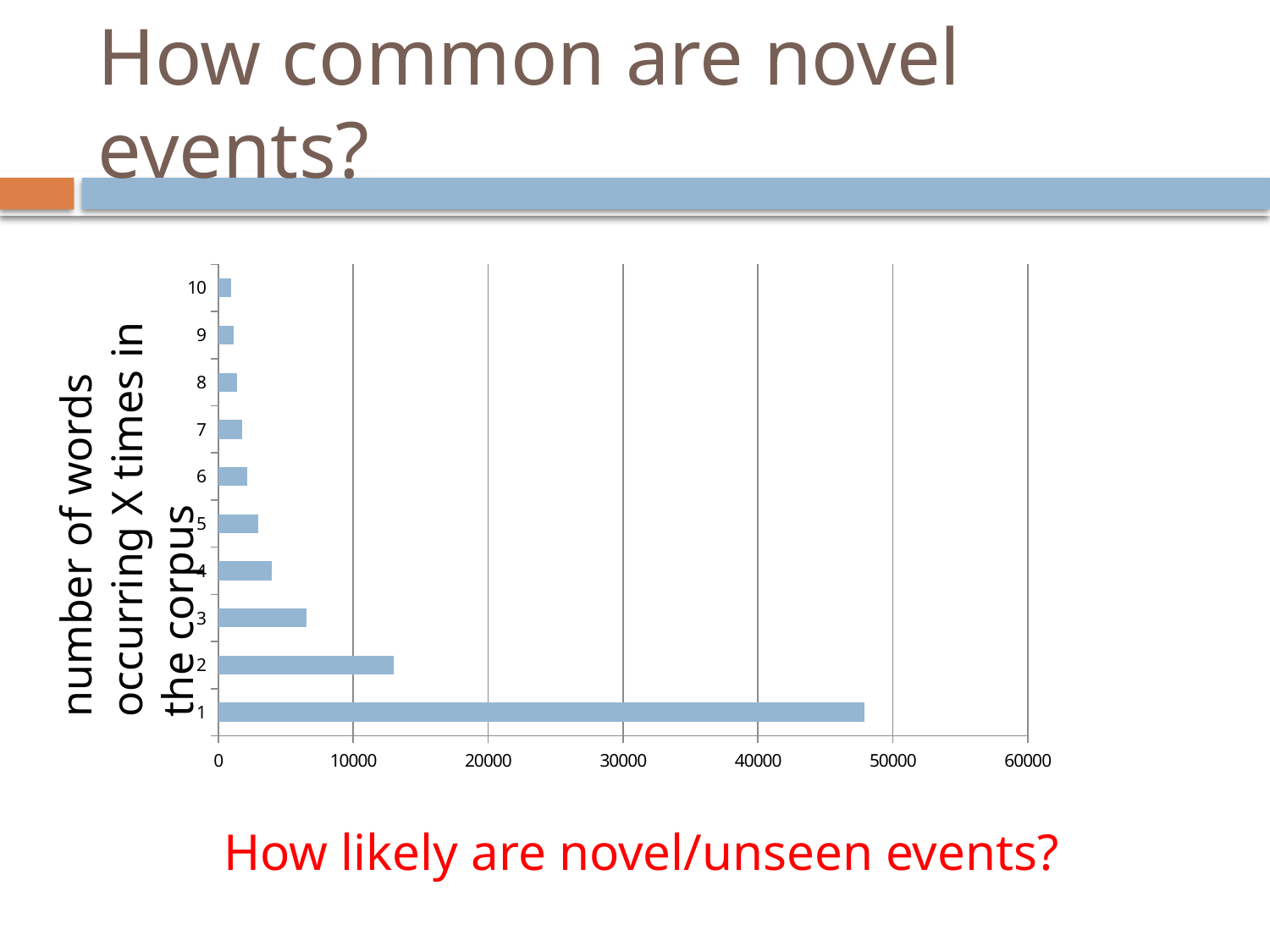
Do the bar values rise or fall as the category number increases from 1 to 10? fall What kind of chart is shown on the slide? bar chart Which is larger, the value for category 2 or the value for category 3? 2 Which category has the shortest bar in the chart? 10 Is the value for category 2 greater or less than 10000? greater What is the highest tick value shown on the horizontal axis? 60000 What is the label on the vertical axis of the chart? number of words occurring X times in the corpus Is the value for category 1 greater or less than 50000? less Is the value for category 3 greater or less than 10000? less How many categories are plotted on the vertical axis of the chart? 10 Which category has the longest bar in the chart? 1